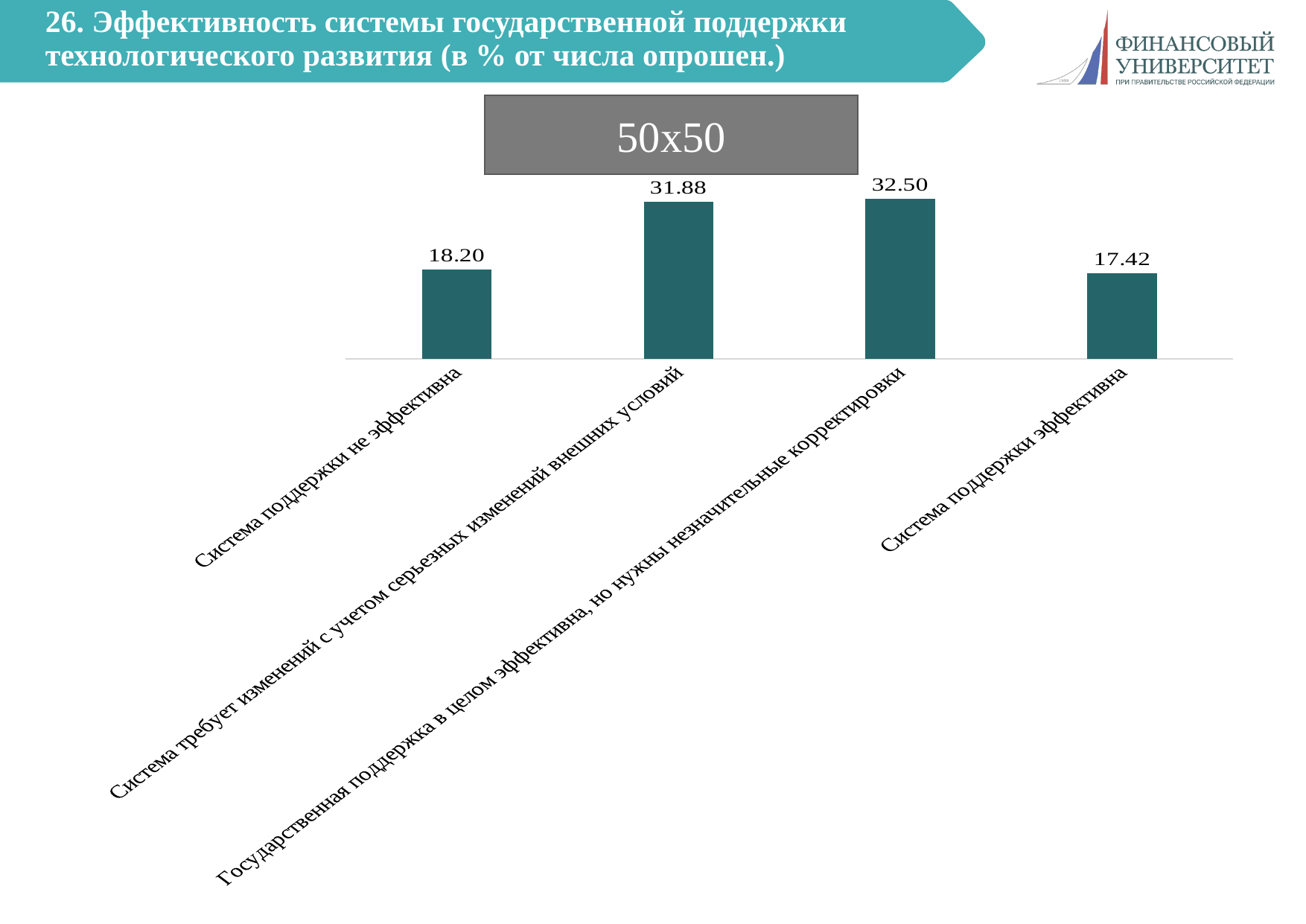
How many categories are shown in the chart? 4 What is the difference between the values for "Государственная поддержка в целом эффективна, но нужны незначительные корректировки" and "Система требует изменений с учетом серьезных изменений внешних условий"? 0.62 What value is shown for the category "Система поддержки эффективна"? 17.42 What type of chart is shown on the slide? Bar chart Which is larger: the value for "Система поддержки не эффективна" or for "Система поддержки эффективна"? Система поддержки не эффективна Which category has the highest value? Государственная поддержка в целом эффективна, но нужны незначительные корректировки What value is shown for the category "Система поддержки не эффективна"? 18.20 What text is shown in the grey box above the chart? 50x50 What value is shown for "Система требует изменений с учетом серьезных изменений внешних условий"? 31.88 What is the difference between the values for "Система поддержки не эффективна" and "Система поддержки эффективна"? 0.78 What value is shown for "Государственная поддержка в целом эффективна, но нужны незначительные корректировки"? 32.50 Which category has the lowest value? Система поддержки эффективна